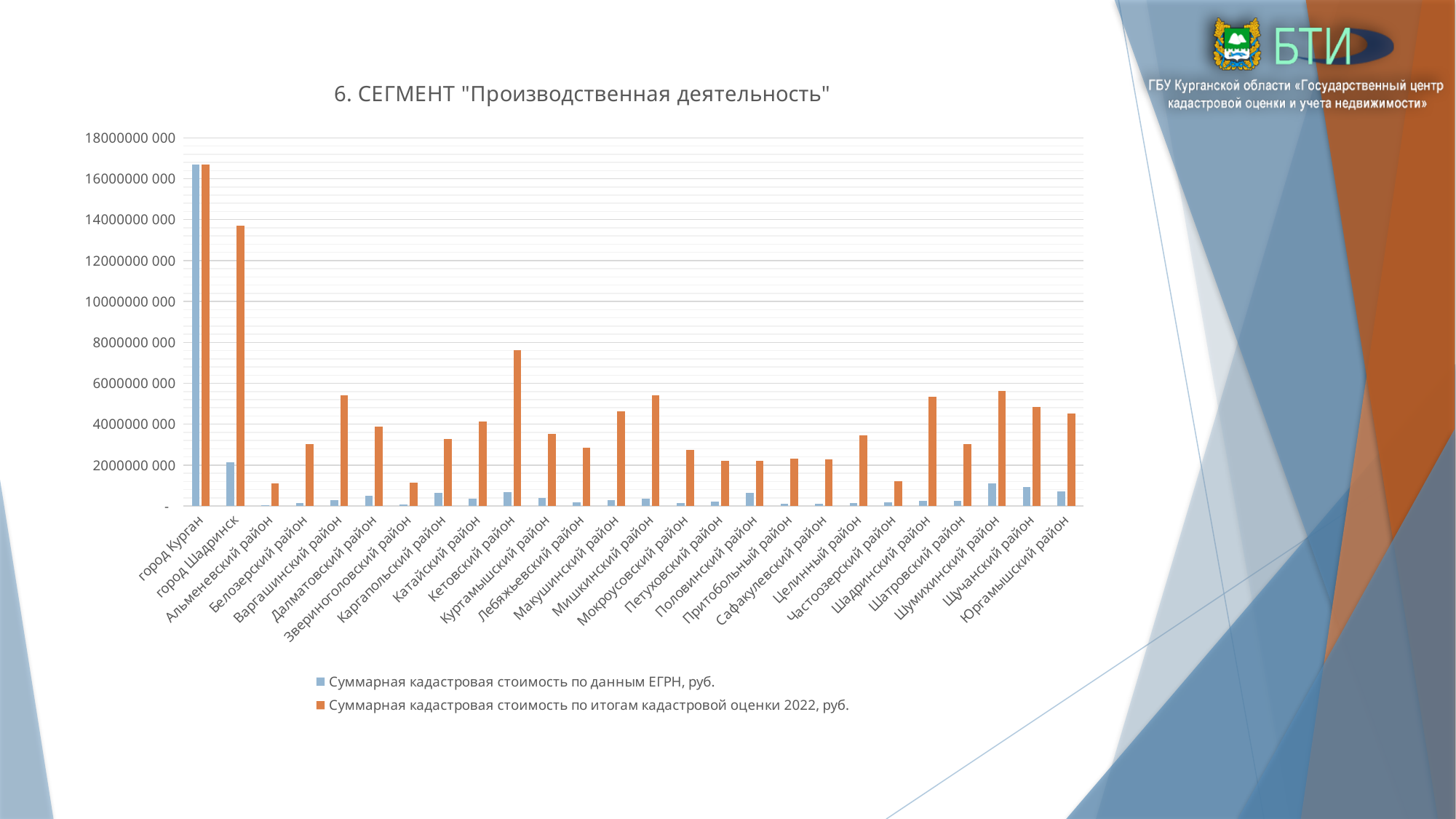
In the series 'Суммарная кадастровая стоимость по данным ЕГРН, руб.', which is larger: город Курган or город Шадринск? город Курган Is the value for город Курган in the series 'Суммарная кадастровая стоимость по данным ЕГРН, руб.' greater or less than 16000000 000? greater How many series does the legend list? 2 Which category has the highest value for 'Суммарная кадастровая стоимость по итогам кадастровой оценки 2022, руб.'? город Курган Is the value for Альменевский район in the series 'Суммарная кадастровая стоимость по итогам кадастровой оценки 2022, руб.' greater or less than 2000000 000? less In the series 'Суммарная кадастровая стоимость по итогам кадастровой оценки 2022, руб.', which is larger: Кетовский район or Шадринский район? Кетовский район How many categories (municipalities) are shown along the x axis? 26 What is the title of the chart? 6. СЕГМЕНТ "Производственная деятельность" Which category has the highest value for 'Суммарная кадастровая стоимость по данным ЕГРН, руб.'? город Курган Is the value for город Шадринск in the series 'Суммарная кадастровая стоимость по итогам кадастровой оценки 2022, руб.' greater or less than 12000000 000? greater What kind of chart is shown on the slide? bar chart